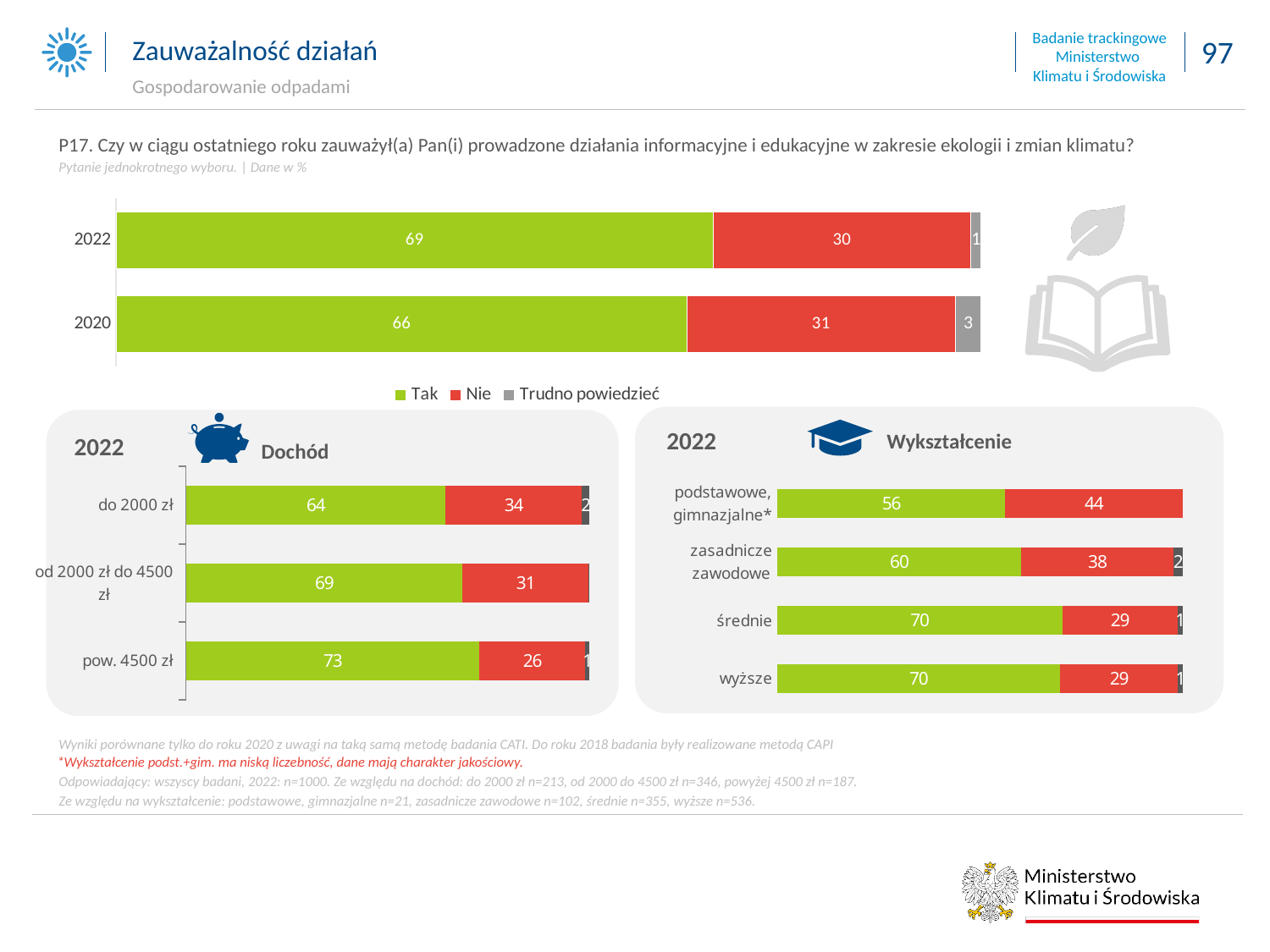
In the "Dochód" chart, what is the "Tak" value for "pow. 4500 zł"? 73 In the top chart comparing 2022 and 2020, what is the value for "Tak" in 2022? 69 In the "Wykształcenie" chart, what is the "Nie" value for "podstawowe, gimnazjalne*"? 44 In the "Dochód" chart, which income group has the lowest "Tak" value? do 2000 zł In the top chart comparing 2022 and 2020, what is the value for "Trudno powiedzieć" in 2020? 3 In the "Wykształcenie" chart, how many education categories are shown? 4 In the top chart comparing 2022 and 2020, what is the value for "Nie" in 2020? 31 In the top chart comparing 2022 and 2020, by how much did the "Tak" value change from 2020 to 2022? 3 In the "Wykształcenie" chart, which is larger: the "Tak" value for "zasadnicze zawodowe" or for "średnie"? średnie In the "Dochód" chart, what is the difference between the "Nie" values for "do 2000 zł" and "pow. 4500 zł"? 8 In the top chart comparing 2022 and 2020, how many series does the legend list? 3 What kind of chart is the "Dochód" chart? Stacked bar chart